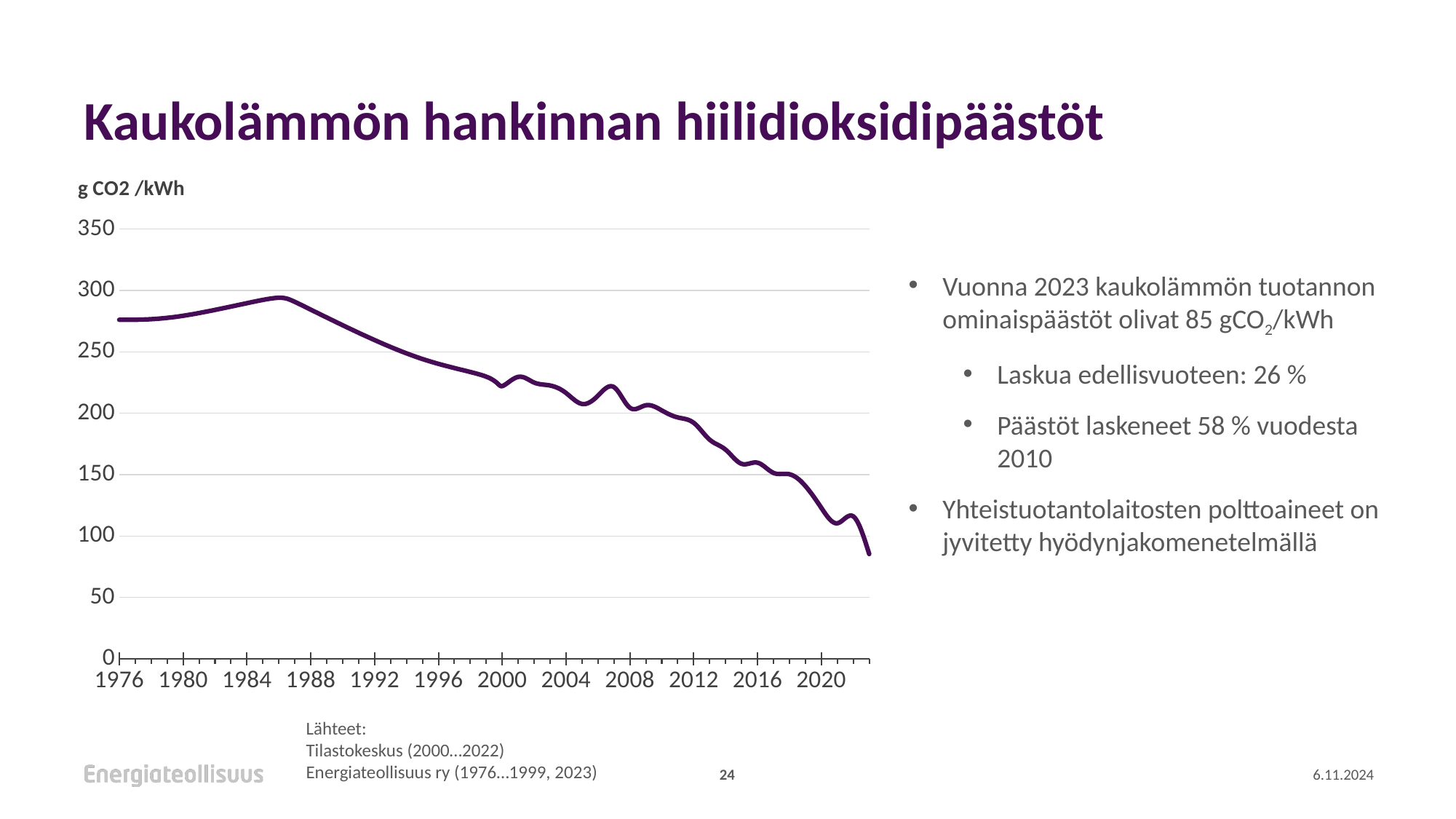
Do the values in the chart generally rise or fall from 1976 to 2023? fall Which year has the larger value, 1988 or 2008? 1988 Is the value for 2020 greater or less than 100? greater Is the value for 2000 greater or less than 200? greater What unit is shown above the y axis of the chart? g CO2 /kWh What is the title of the chart on the slide? Kaukolämmön hankinnan hiilidioksidipäästöt According to the slide, what was the specific emission value of district heating production in 2023? 85 gCO2/kWh What kind of chart is shown on the slide? line chart In which year does the line reach its lowest value? 2023 Is the value for 2012 greater or less than 200? less